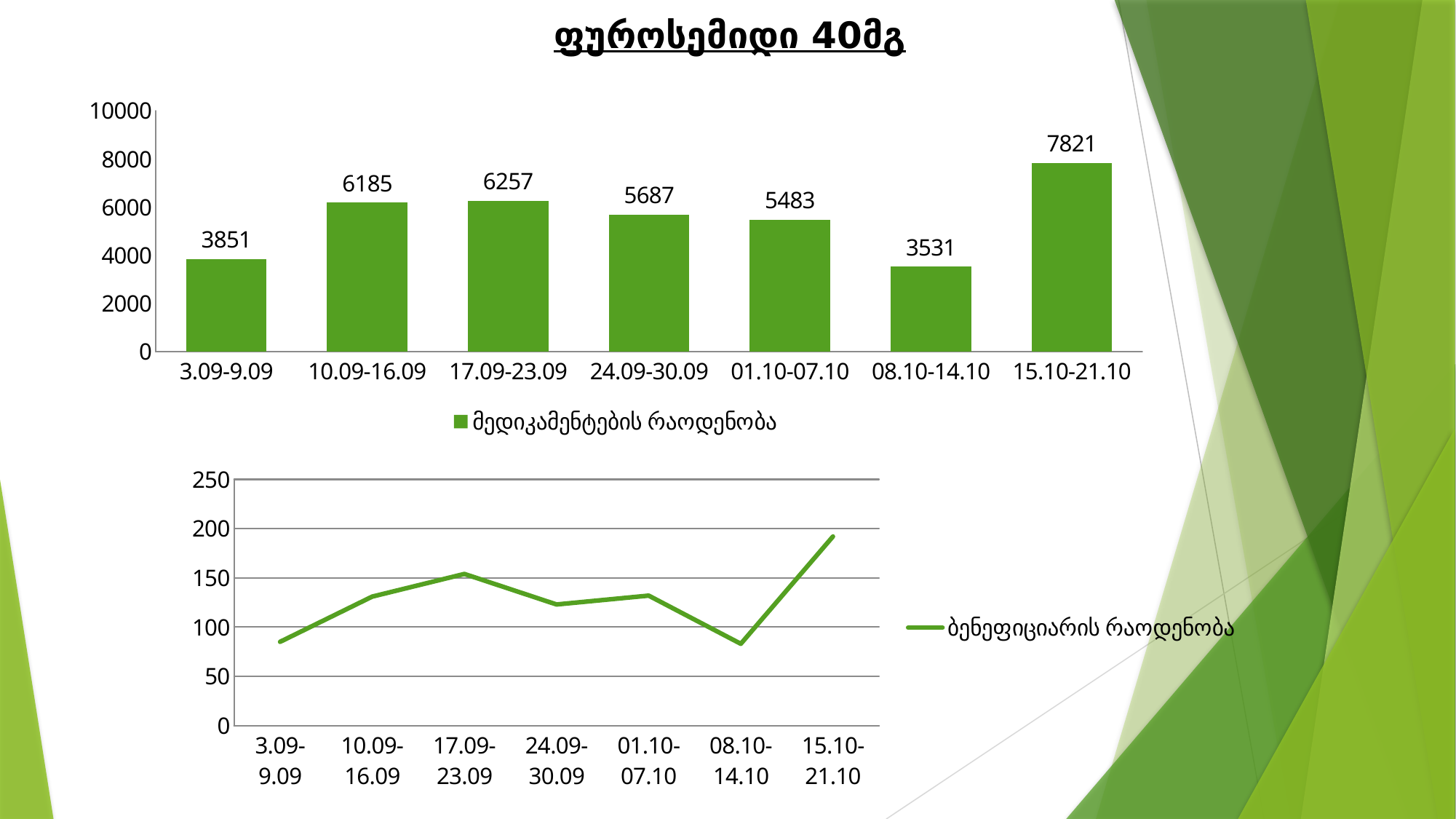
In the top bar chart, which is larger: the value for 10.09-16.09 or the value for 01.10-07.10? 10.09-16.09 How many periods are shown on the x axis of the top bar chart? 7 What type of chart is the bottom chart on the slide? Line chart In the bottom line chart, which period has the highest value? 15.10-21.10 In the top bar chart, what is the value for 15.10-21.10? 7821 In the top bar chart, which period has the lowest value? 08.10-14.10 What is the legend entry of the top bar chart? მედიკამენტების რაოდენობა In the top bar chart, which period has the highest value? 15.10-21.10 In the top bar chart, what is the difference between the values for 15.10-21.10 and 08.10-14.10? 4290 In the bottom line chart, is the value for 08.10-14.10 greater or less than 100? less In the top bar chart, what is the value for 24.09-30.09? 5687 In the bottom line chart, is the value for 15.10-21.10 greater or less than 150? greater